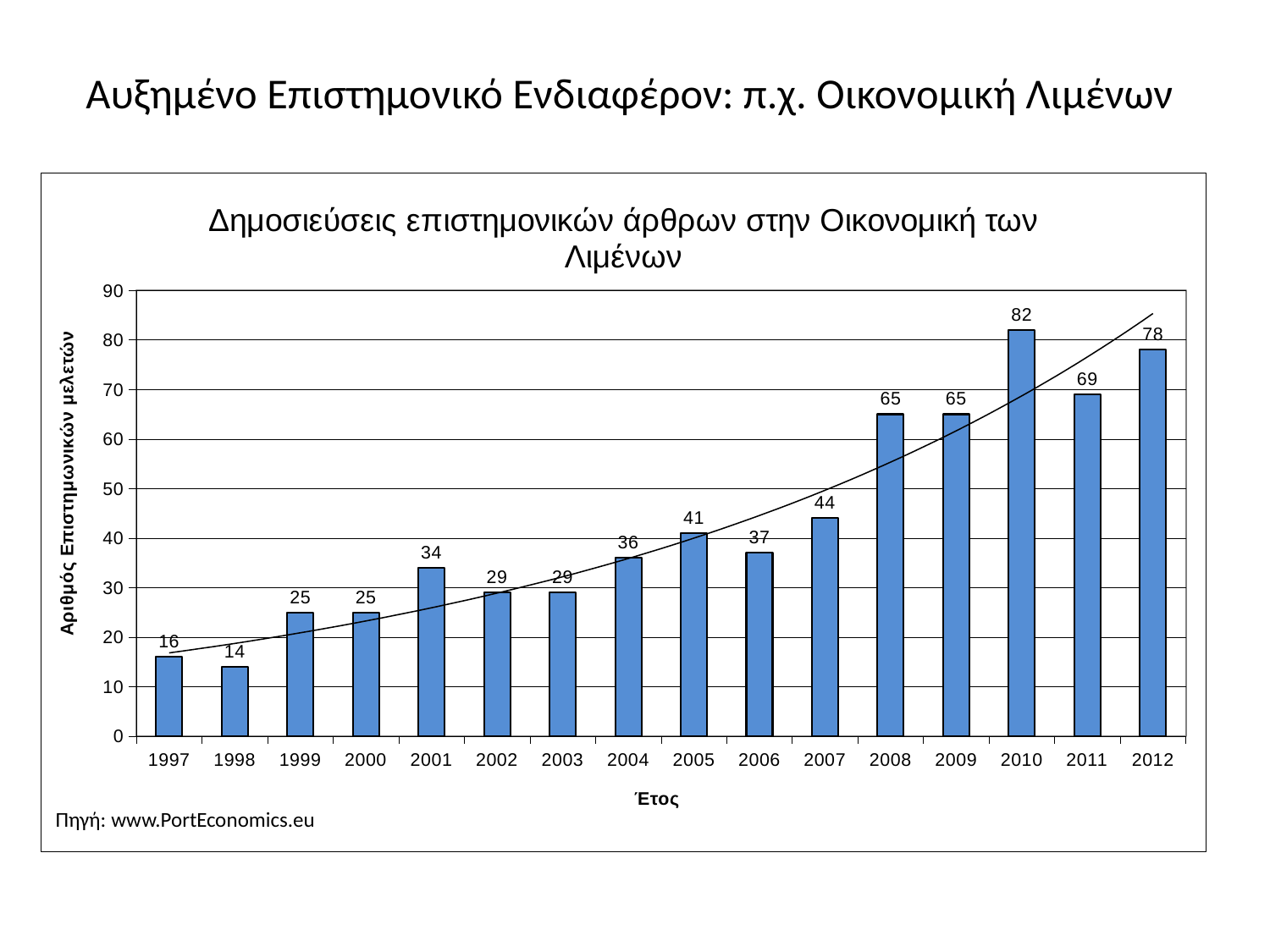
Do the values generally rise or fall from 1997 to 2012? rise What is the value for 1997? 16 Which year has the lowest value? 1998 What kind of chart is this? bar chart Which year has the highest value? 2010 What is the difference between the values for 2010 and 2009? 17 What is the value for 2010? 82 How many years are shown on the x axis? 16 What is the difference between the values for 2012 and 2011? 9 What is the value for 2006? 37 Which is larger, the value for 2005 or the value for 2006? 2005 What is the label of the x axis? Έτος